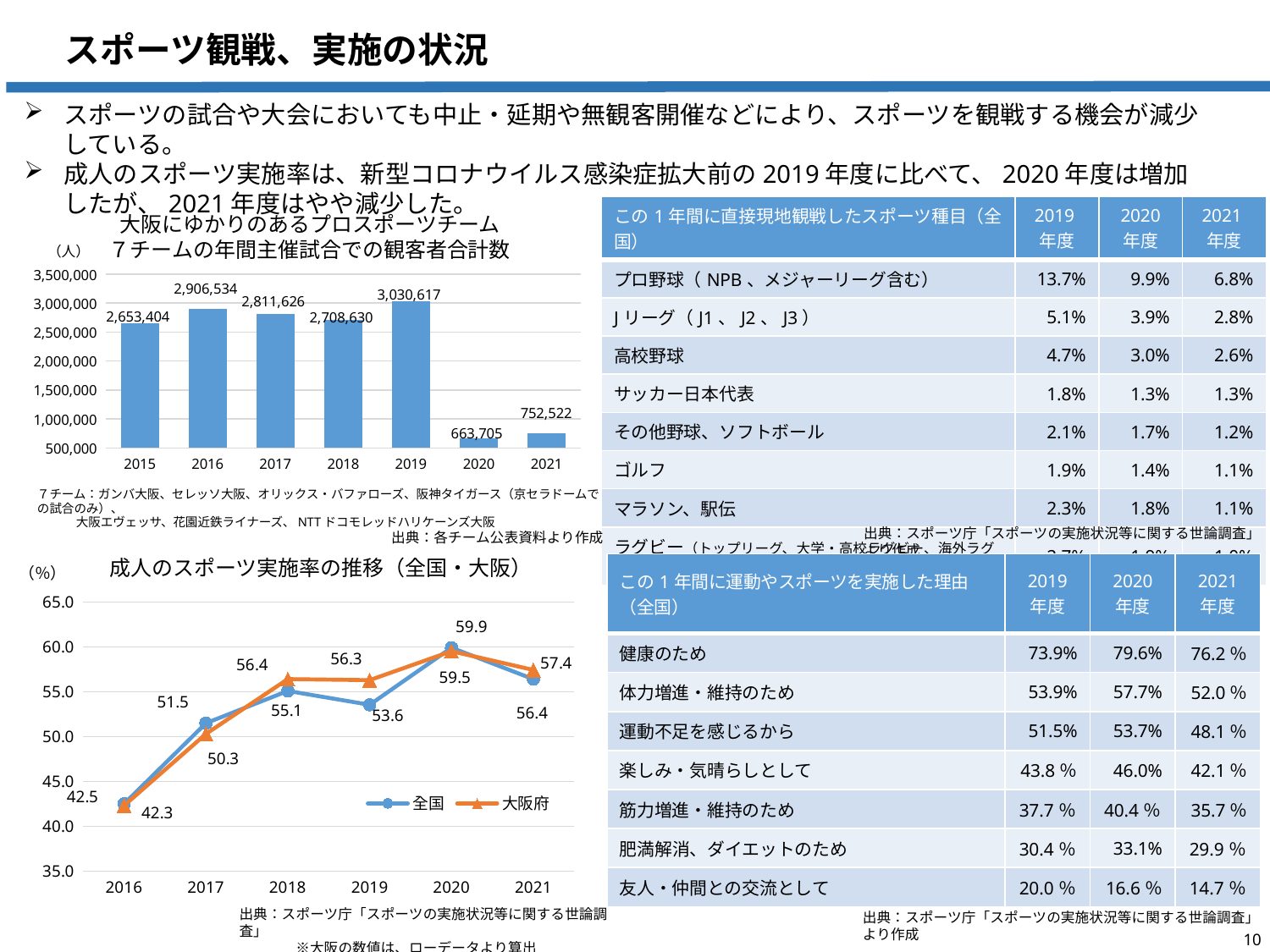
In the line chart of adult sports participation rate (全国・大阪), what is the value for 大阪府 in 2021? 57.4 In the bar chart of total spectators at home games of the 7 Osaka-related pro sports teams, how many years are shown? 7 In the line chart of adult sports participation rate (全国・大阪), what is the difference between the 全国 values for 2020 and 2021? 3.5 In the line chart of adult sports participation rate (全国・大阪), how many series does the legend list? 2 In the line chart of adult sports participation rate (全国・大阪), what is the value for 全国 in 2020? 59.9 In the bar chart of total spectators at home games of the 7 Osaka-related pro sports teams, what is the value for 2019? 3,030,617 In the bar chart of total spectators at home games of the 7 Osaka-related pro sports teams, which year has the lowest value? 2020 What kind of chart is the top-left chart showing spectator totals for the 7 Osaka-related pro sports teams? Bar chart In the bar chart of total spectators at home games of the 7 Osaka-related pro sports teams, what is the difference between the 2021 and 2020 values? 88,817 In the bar chart of total spectators at home games of the 7 Osaka-related pro sports teams, which year has the highest value? 2019 In the line chart of adult sports participation rate (全国・大阪), which is larger in 2019: 全国 or 大阪府? 大阪府 In the bar chart of total spectators at home games of the 7 Osaka-related pro sports teams, what is the value for 2020? 663,705